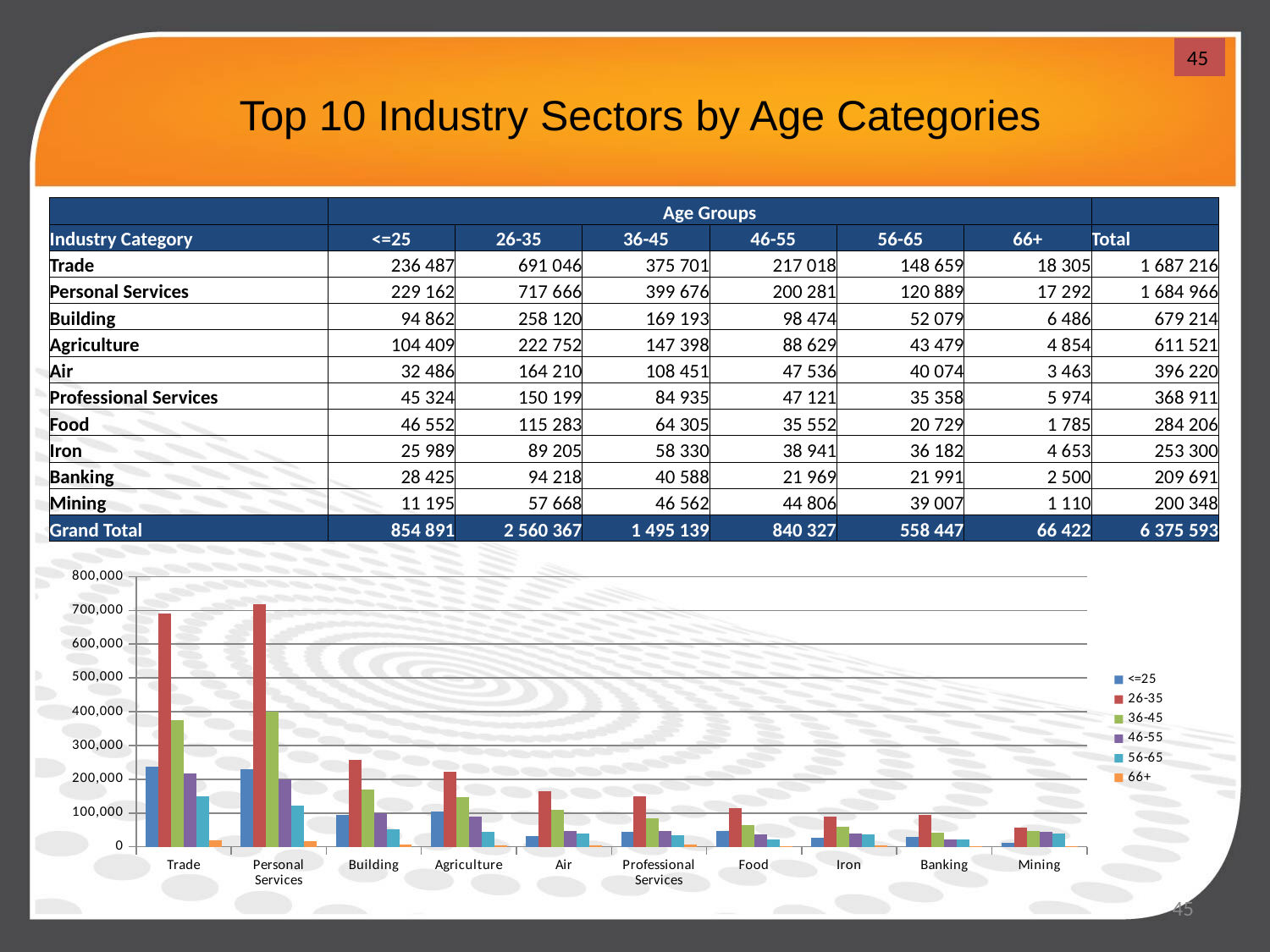
Is the <=25 value for Air greater or less than 100,000? less According to the table, what is the value for Mining in the 46-55 age group? 44 806 According to the table, what is the value for Trade in the 26-35 age group? 691 046 Using the table values, what is the difference between the 26-35 value for Personal Services and the 26-35 value for Trade? 26 620 Which age group has the lowest value for Trade? 66+ Which age group has the highest value for Trade? 26-35 How many industry categories are plotted along the x axis of the chart? 10 What colour represents the 26-35 series in the chart? red Is the 26-35 value for Building greater or less than 200,000? greater What kind of chart is shown on the slide? bar chart How many series does the chart's legend list? 6 Which is larger, the 26-35 value for Building or the 26-35 value for Agriculture? Building